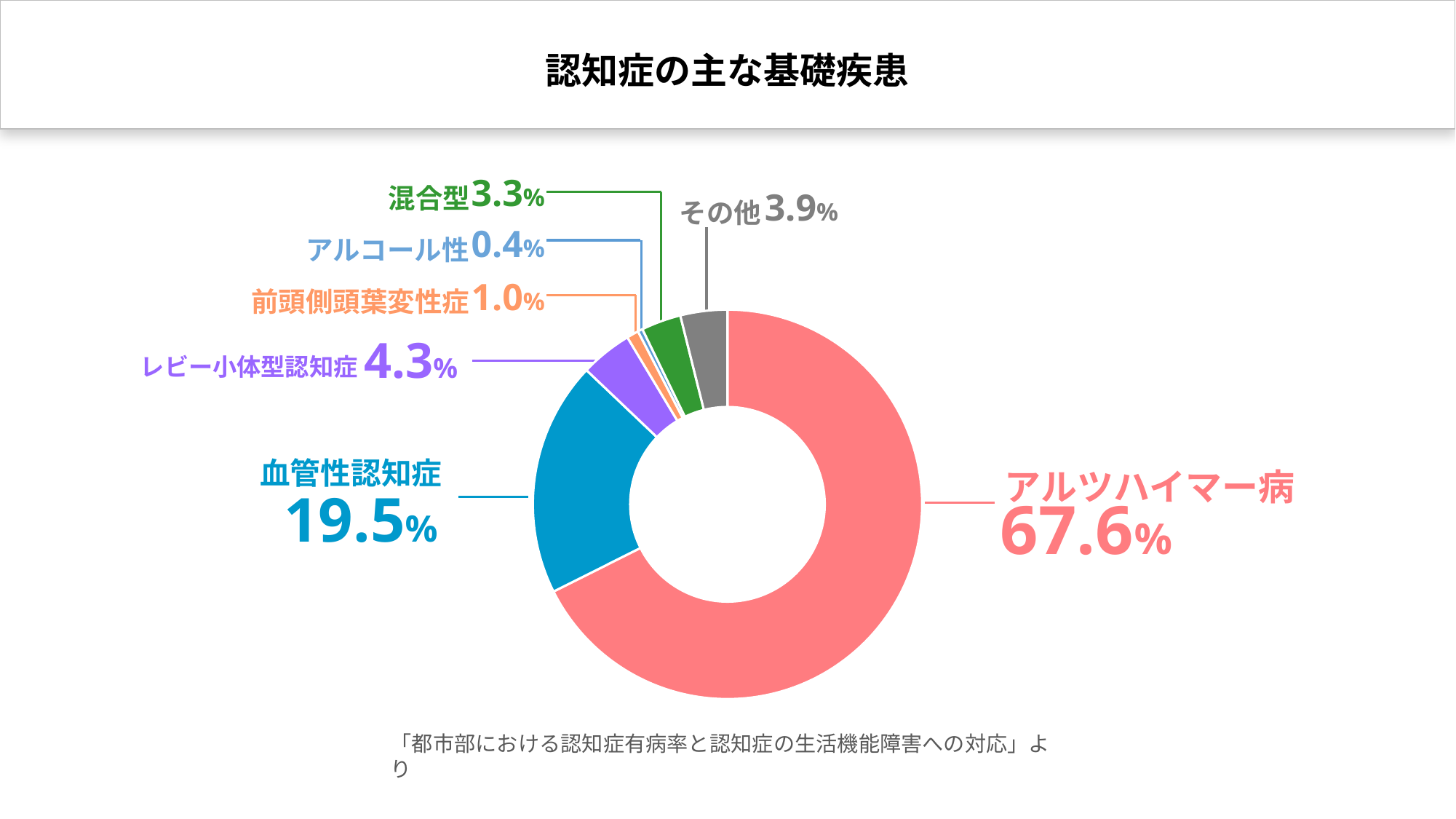
What share of the pie does アルツハイマー病 account for? 67.6% What is the difference between the values for アルツハイマー病 and 血管性認知症? 48.1% How many categories are shown in the chart? 7 Which category has the largest share of the pie? アルツハイマー病 What is the value shown for レビー小体型認知症? 4.3% What kind of chart is shown on the slide? Pie chart (donut) Which is larger, the value for その他 or the value for 混合型? その他 What is the value shown for 血管性認知症? 19.5% What is the value shown for アルコール性? 0.4% What is the title of the chart? 認知症の主な基礎疾患 Which category has the smallest share of the pie? アルコール性 What is the value shown for 混合型? 3.3%